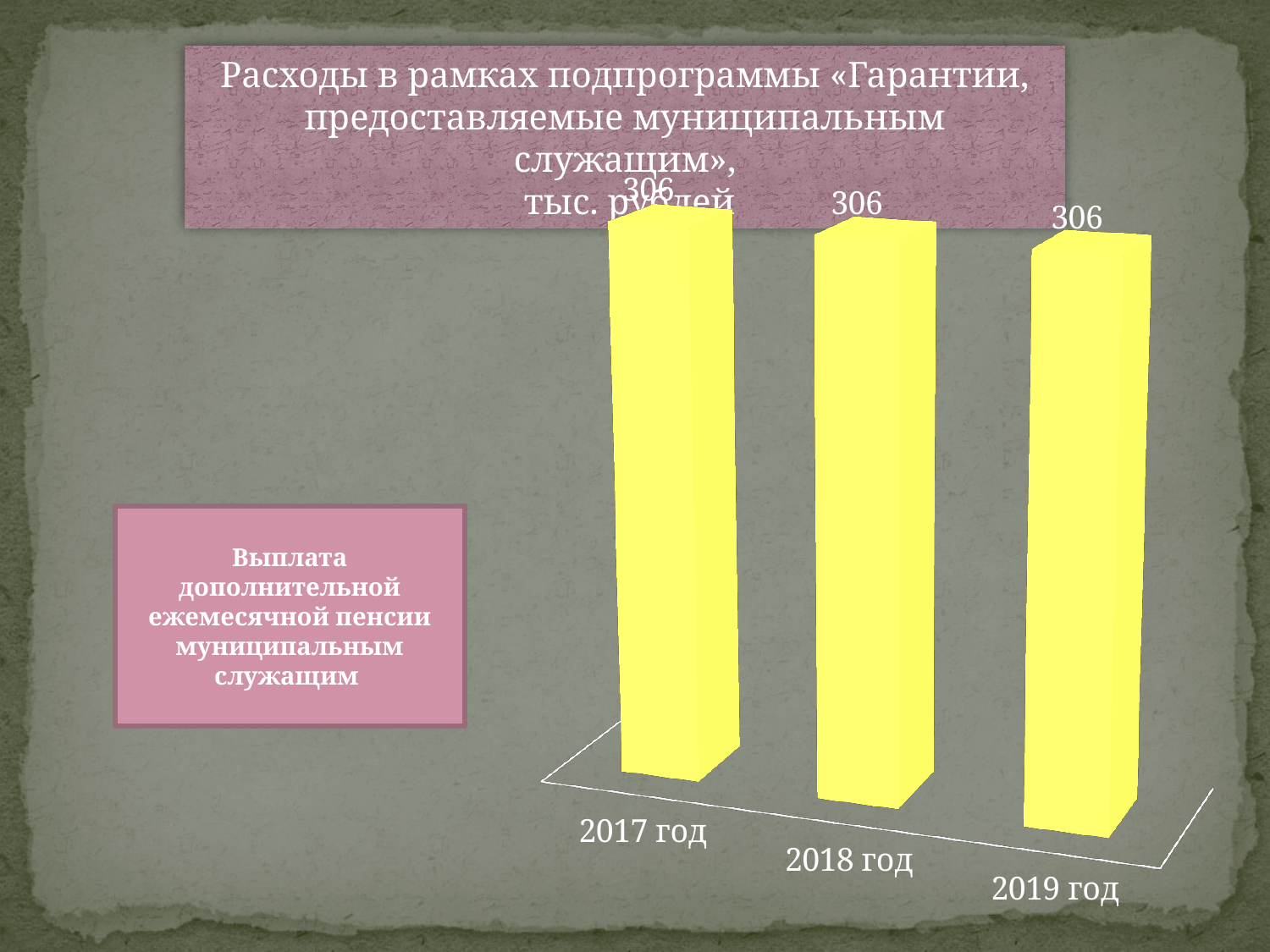
How many categories (years) are shown on the chart? 3 What is the difference between the values for 2017 год and 2019 год? 0 What colour are the bars on the chart? yellow Do the values rise, fall, or stay the same from 2017 год to 2019 год? stay the same What is the value for 2018 год? 306 What is the value for 2017 год? 306 What is the value for 2019 год? 306 What is the difference between the values for 2018 год and 2019 год? 0 What kind of chart is shown on the slide? bar chart In what units are the values on the chart expressed, according to the title? тыс. рублей